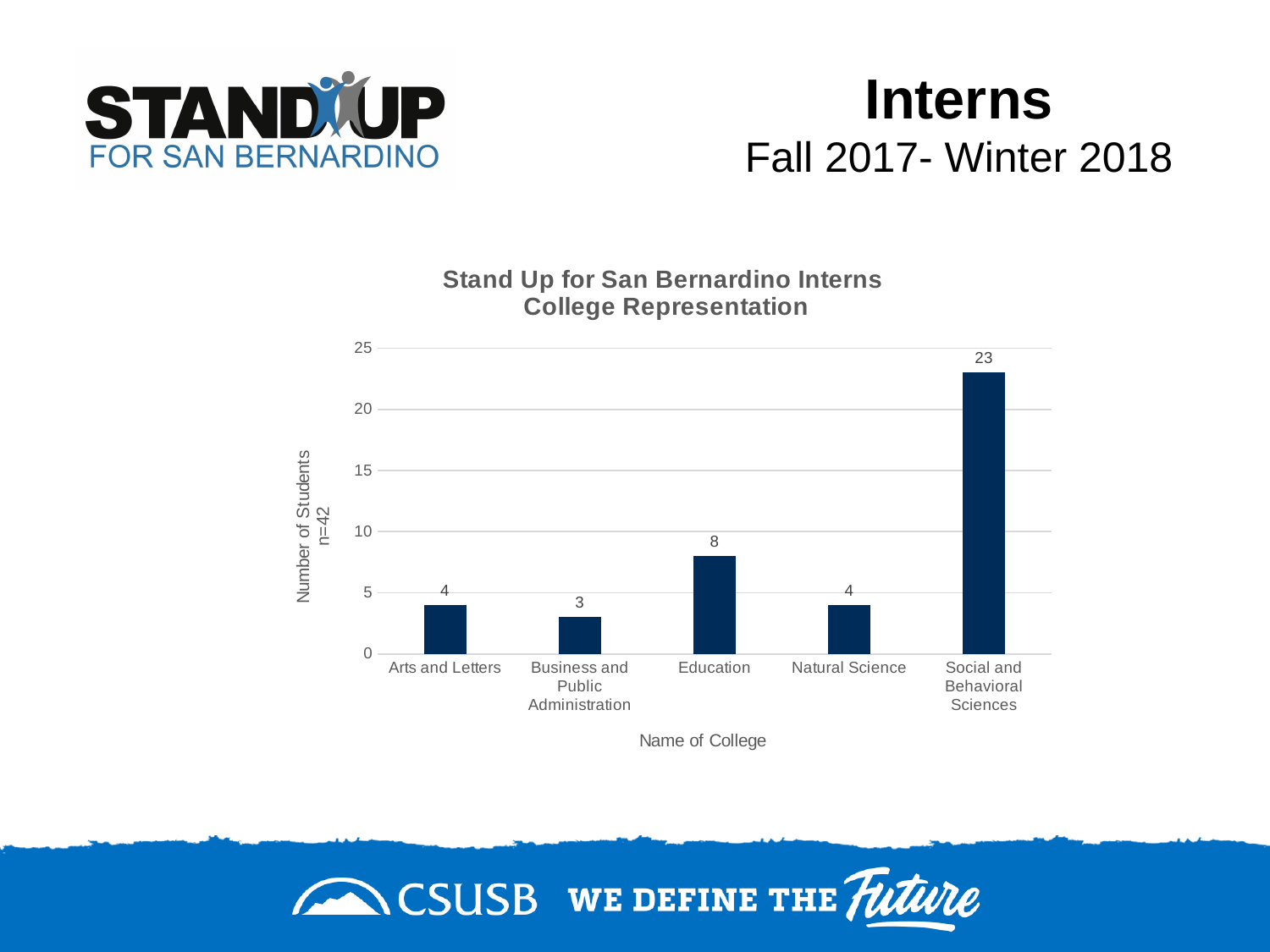
What is the difference in number of students between Arts and Letters and Business and Public Administration? 1 Which has more students, Education or Natural Science? Education What is the difference in number of students between Social and Behavioral Sciences and Education? 15 How many colleges are shown on the x axis? 5 Is the value for Social and Behavioral Sciences greater or less than 20? greater What is the number of students for Business and Public Administration? 3 What is the number of students for Social and Behavioral Sciences? 23 What is the label of the x axis? Name of College Which college has the highest number of students? Social and Behavioral Sciences Which college has the lowest number of students? Business and Public Administration How many students are from the College of Education? 8 What kind of chart is shown on the slide? bar chart